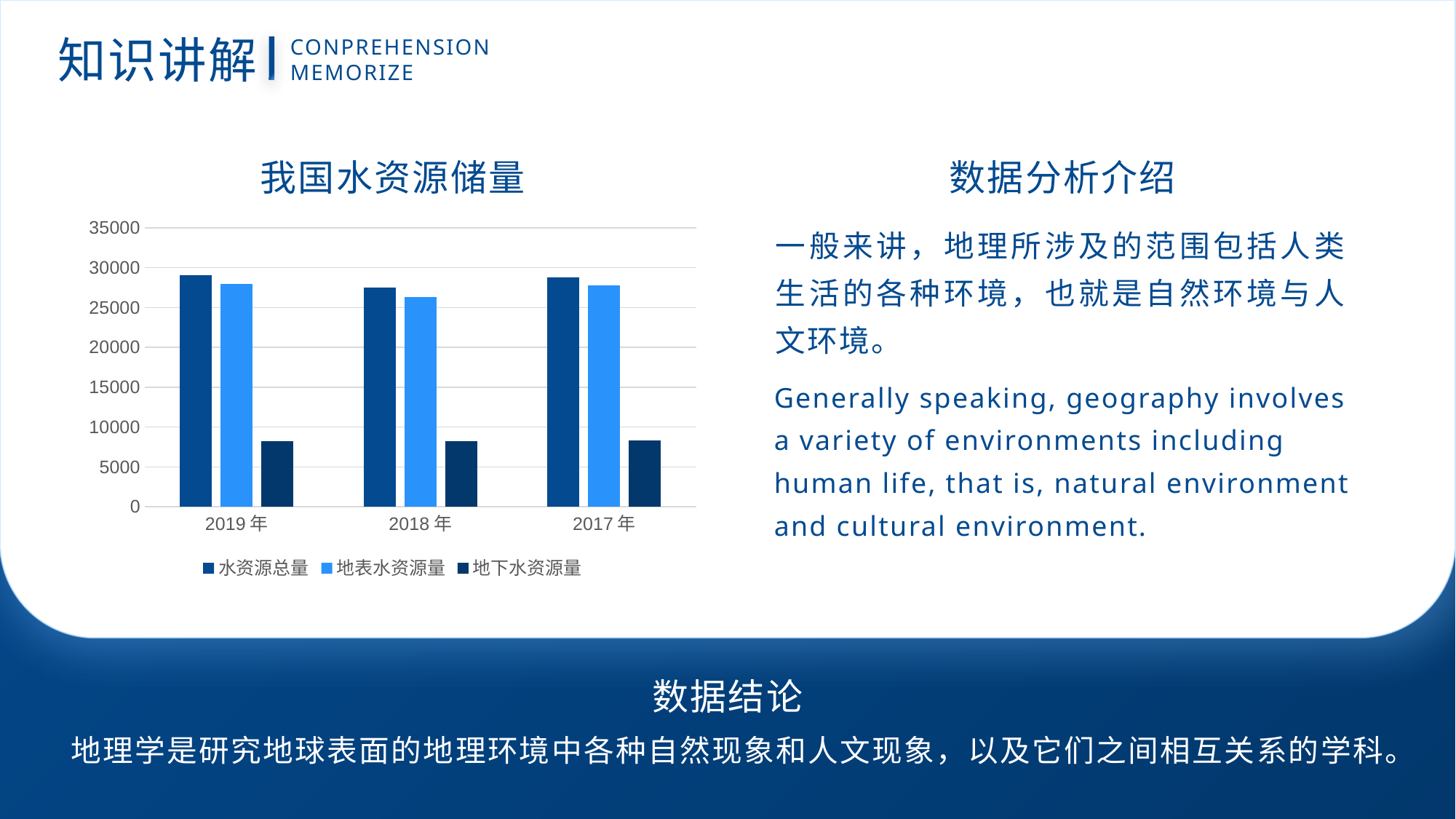
What is the title of the chart? 我国水资源储量 How many year categories are shown on the x axis of the chart? 3 In which year is the value of 水资源总量 the lowest? 2018 年 Is the value of 地下水资源量 for 2017 年 greater or less than 5000? greater How many series does the chart legend list? 3 Is the value of 地下水资源量 for 2018 年 greater or less than 10000? less For 2019 年, which is larger: 地表水资源量 or 地下水资源量? 地表水资源量 In which year is the value of 地表水资源量 the lowest? 2018 年 Which series is shown in the lightest blue in the chart legend? 地表水资源量 What kind of chart is shown on the slide? bar chart Is the value of 地表水资源量 for 2017 年 greater or less than 30000? less